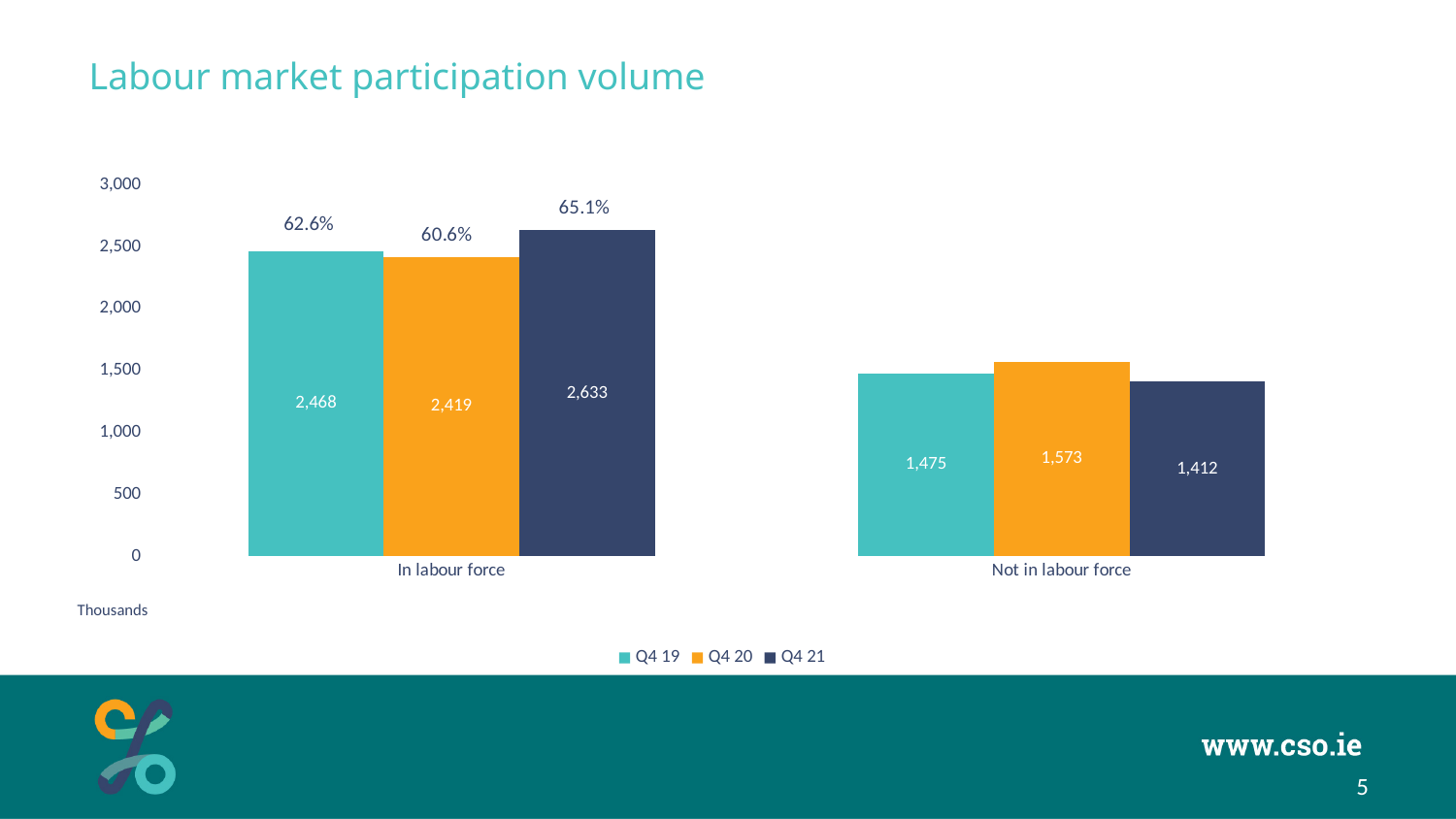
What is the title of the chart? Labour market participation volume What kind of chart is shown on the slide? Bar chart Which series has the lowest value in the 'Not in labour force' category? Q4 21 What is the value for Q4 19 in the 'Not in labour force' category? 1,475 What is the value for Q4 21 in the 'In labour force' category? 2,633 How many series does the legend list? 3 Which series has the highest value in the 'In labour force' category? Q4 21 What is the value for Q4 20 in the 'Not in labour force' category? 1,573 What is the difference between the Q4 21 and Q4 20 values for 'In labour force'? 214 What participation rate percentage is shown above the Q4 21 bar for 'In labour force'? 65.1% What is the difference between the Q4 20 and Q4 19 values for 'Not in labour force'? 98 Which is larger: the Q4 19 value for 'In labour force' or the Q4 20 value for 'In labour force'? Q4 19